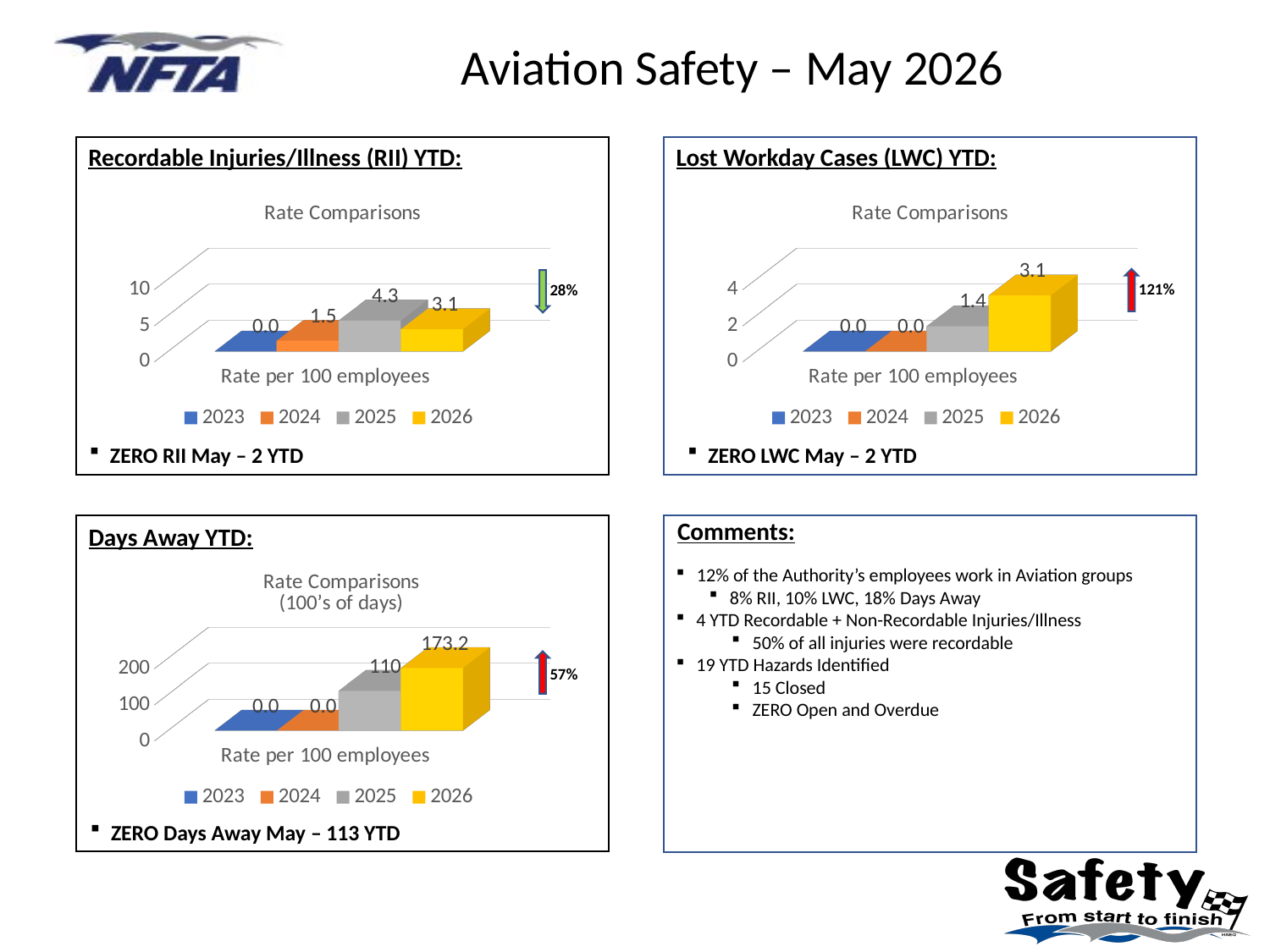
In the Lost Workday Cases (LWC) YTD chart, is the value for 2025 larger or smaller than the value for 2026? smaller In the Lost Workday Cases (LWC) YTD chart, which year has the highest value? 2026 In the Recordable Injuries/Illness (RII) YTD chart, what is the difference between the 2025 and 2026 values? 1.2 How many series does the legend list in the Days Away YTD chart? 4 In the Recordable Injuries/Illness (RII) YTD chart, what is the value for 2025? 4.3 In the Lost Workday Cases (LWC) YTD chart, what is the value for 2026? 3.1 In the Recordable Injuries/Illness (RII) YTD chart, which year has the highest value? 2025 In the Recordable Injuries/Illness (RII) YTD chart, what is the value for 2026? 3.1 What is the x-axis label of the Recordable Injuries/Illness (RII) YTD chart? Rate per 100 employees In the Days Away YTD chart, what is the difference between the 2026 and 2025 values? 63.2 What kind of chart is the Lost Workday Cases (LWC) YTD chart? bar chart In the Days Away YTD chart, what is the value for 2026? 173.2